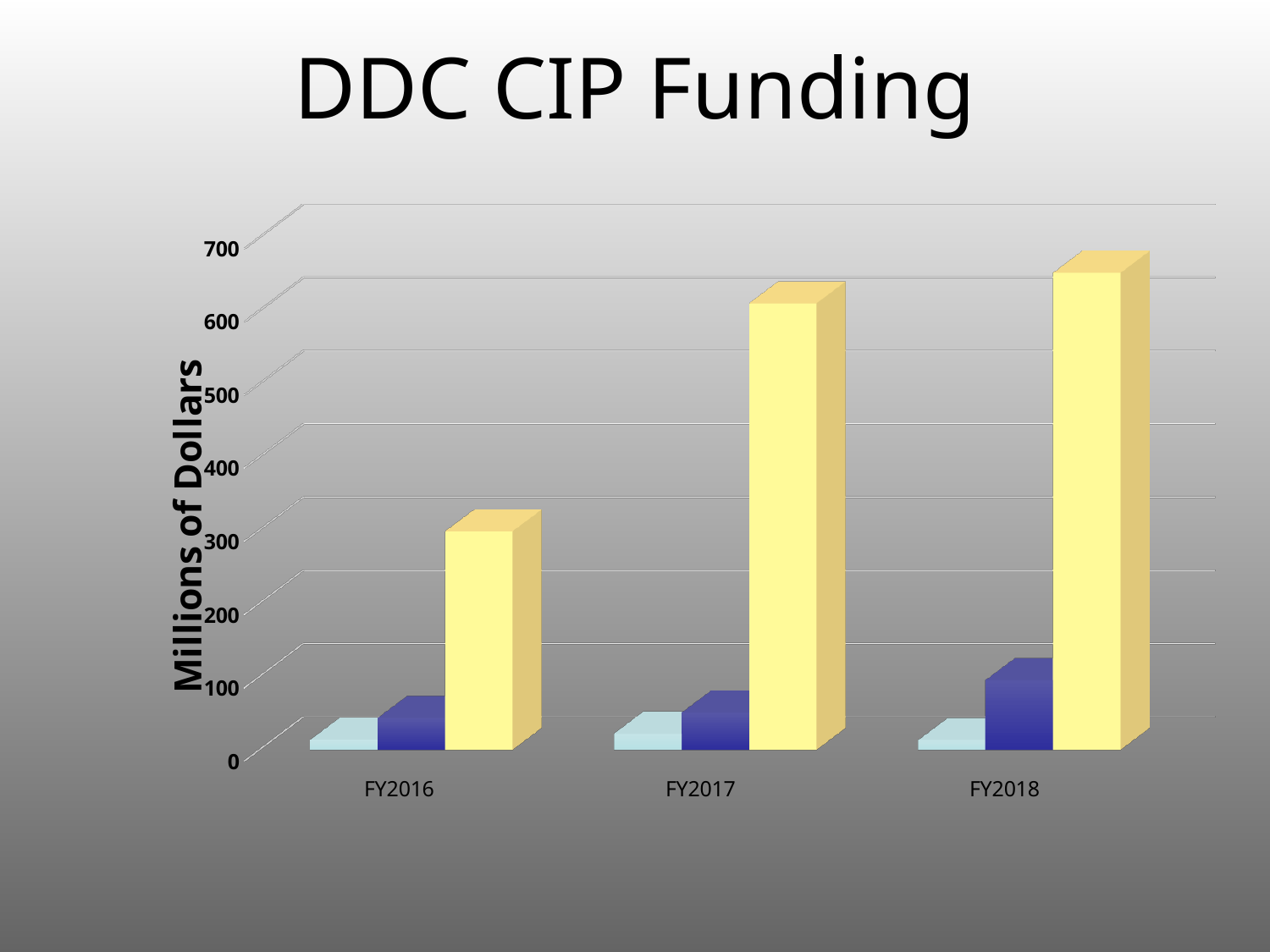
Is the value of the yellow bar for FY2016 greater or less than 200? greater Do the yellow bars rise or fall from FY2016 to FY2018? rise Is the value of the yellow bar for FY2016 greater or less than 400? less How many fiscal years are shown on the x axis of the chart? 3 Is the value of the light blue bar for FY2017 greater or less than 100? less What kind of chart is shown on the slide? bar chart Which fiscal year has the lowest yellow bar? FY2016 What is the title of the chart? DDC CIP Funding What is the label on the vertical axis of the chart? Millions of Dollars Which fiscal year has the highest yellow bar? FY2018